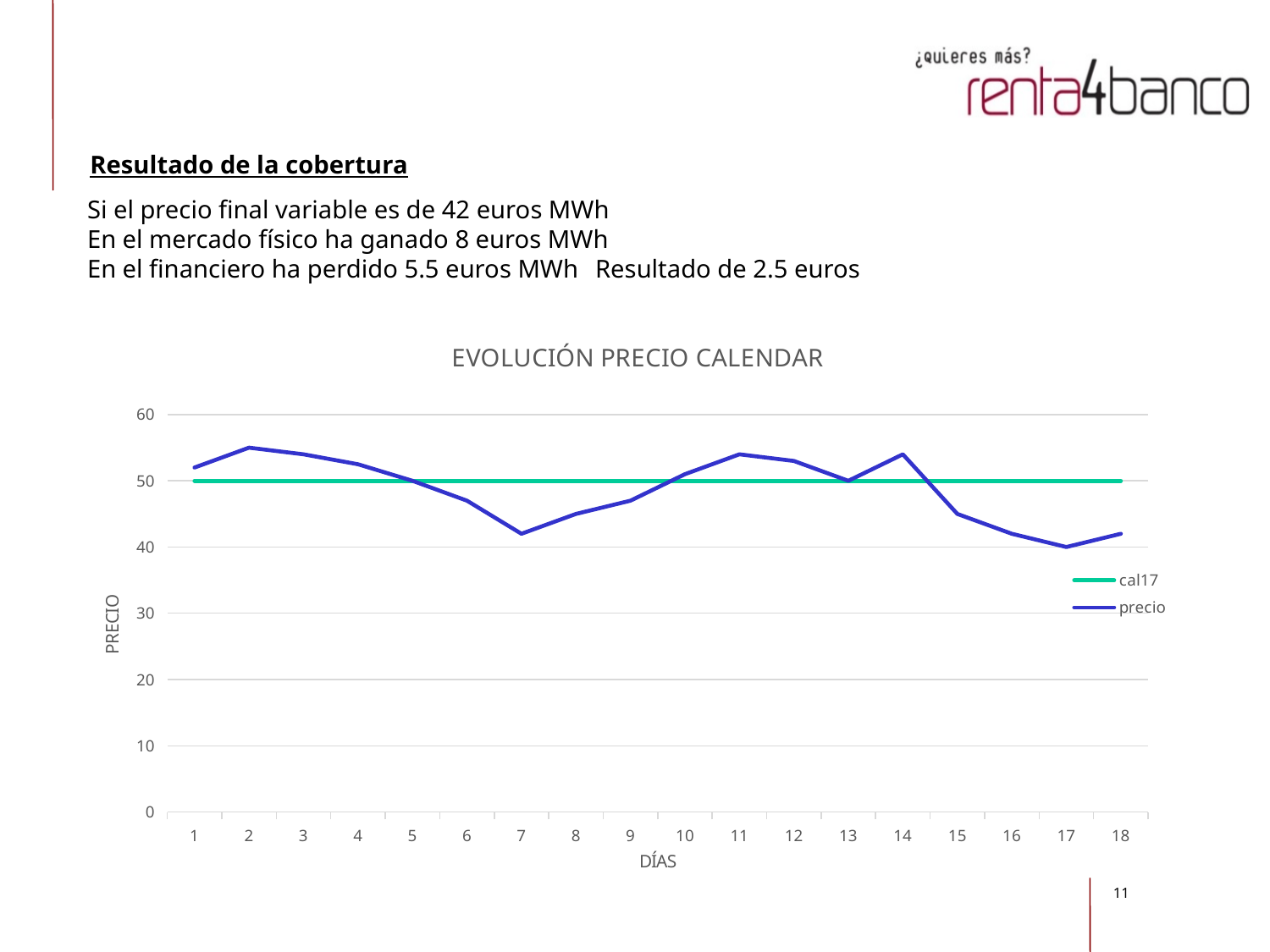
How many days are shown on the x axis? 18 Does the precio series rise or fall from day 2 to day 7? fall How many series does the legend list? 2 Is the value of precio on day 7 greater or less than 50? less Is the value of precio on day 2 greater or less than 50? greater What kind of chart is shown on the slide? line chart What is the value of the cal17 series on day 5? 50 Is the value of precio on day 17 greater or less than 50? less What is the label of the x axis? DÍAS Which is larger, the precio value on day 2 or on day 7? day 2 What is the title of the chart? EVOLUCIÓN PRECIO CALENDAR